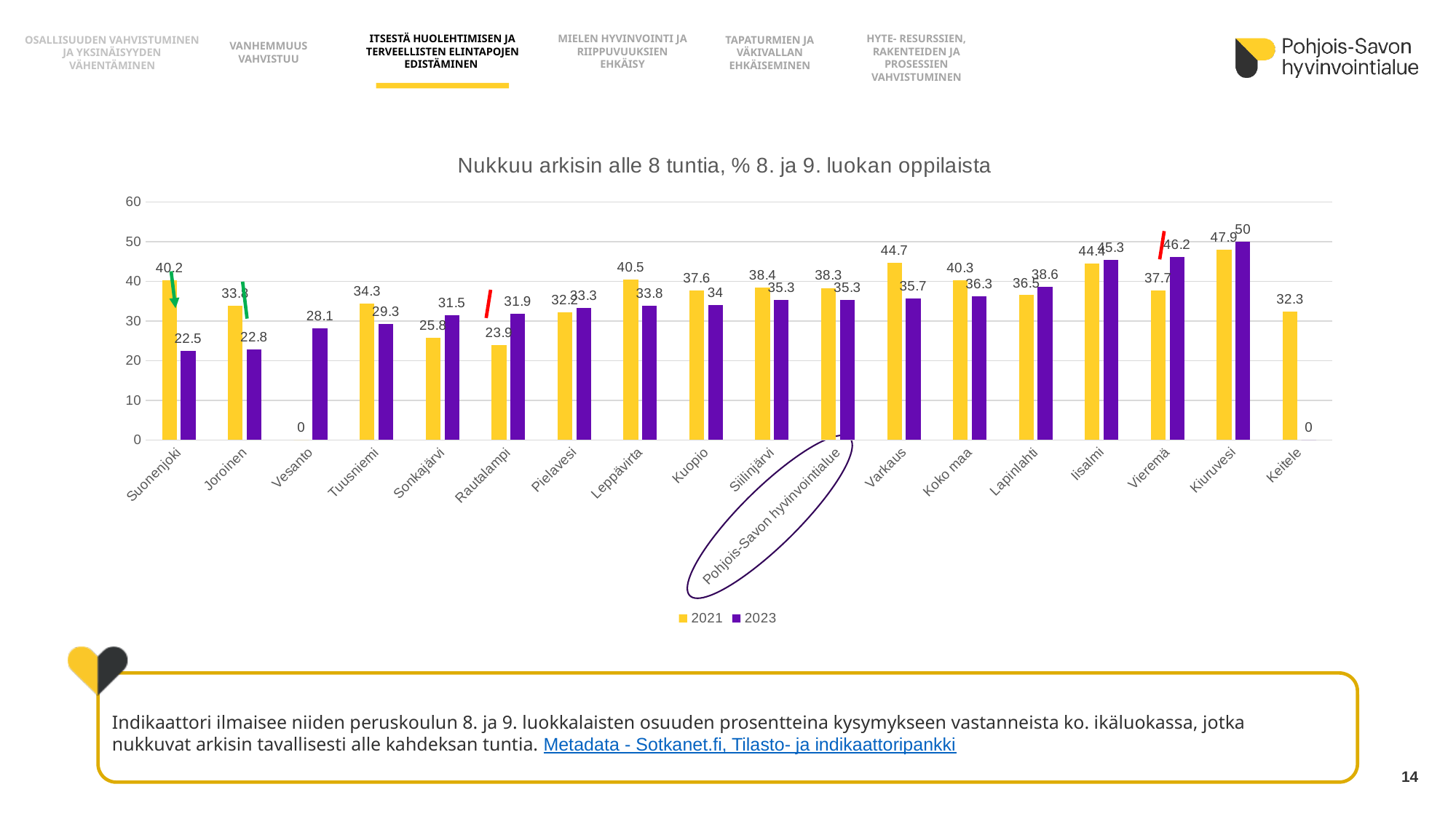
What is the difference between the 2021 and 2023 values for Suonenjoki? 17.7 What kind of chart is shown on the slide? Bar chart Which category has the highest 2023 value? Kiuruvesi What is the 2021 value for Varkaus? 44.7 Is the 2023 value for Iisalmi greater or less than 40? greater What is the 2021 value for Koko maa? 40.3 Which is larger for Vieremä, the 2021 value or the 2023 value? 2023 What is the 2023 value for Pohjois-Savon hyvinvointialue? 35.3 Which category has the highest 2021 value? Kiuruvesi How many series does the legend list? 2 What is the title of the chart? Nukkuu arkisin alle 8 tuntia, % 8. ja 9. luokan oppilaista What is the 2023 value for Kuopio? 34